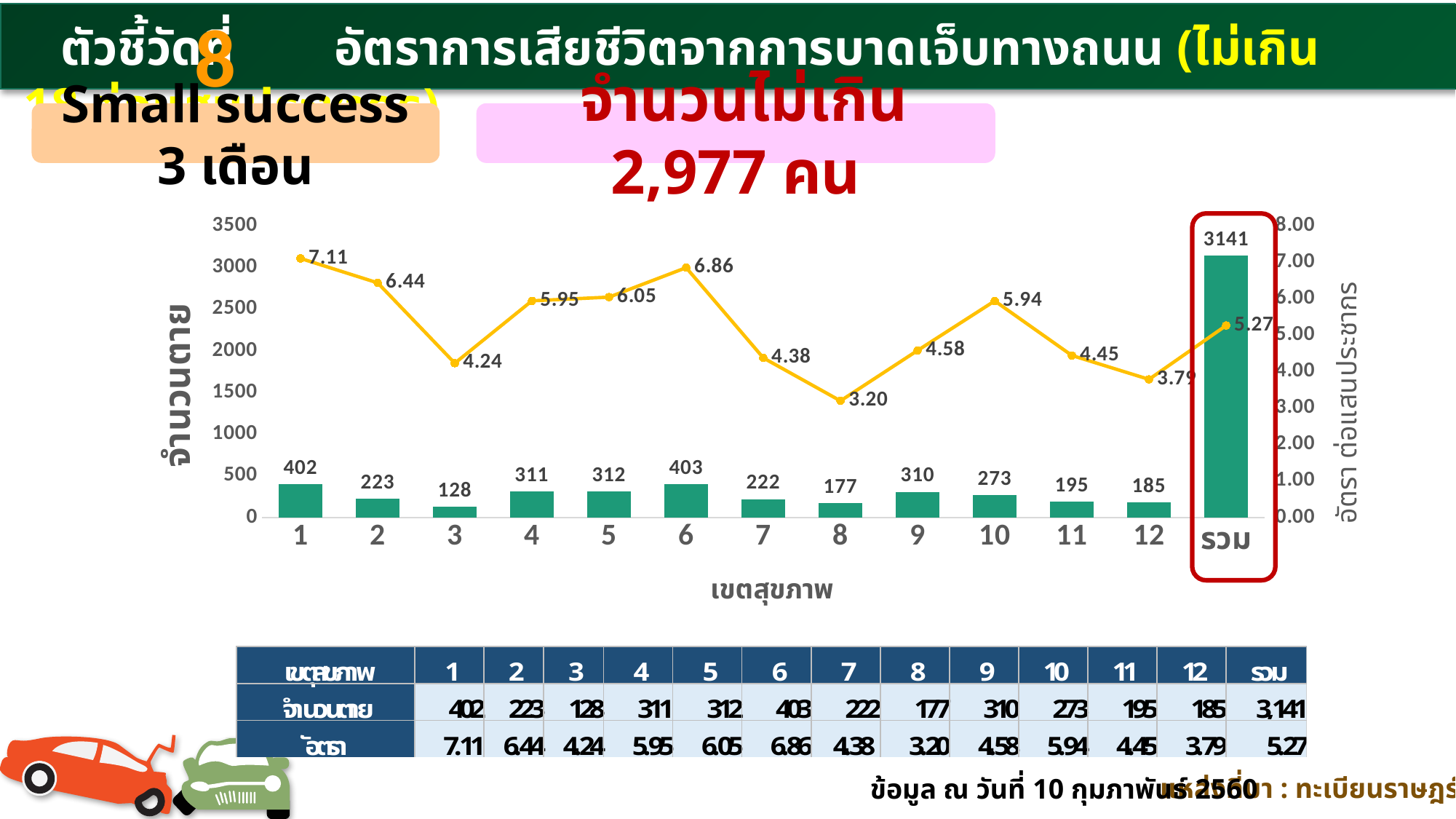
Does the rate line rise or fall from health region 1 to health region 3? Fall How many categories are shown on the x axis of the chart? 13 Which health region (1-12) has the lowest rate on the line? 8 What is the rate (line value) for health region 8? 3.20 What is the number of deaths (bar value) for health region 1? 402 What kind of chart is shown on the slide? Combination bar and line chart What is the value of the รวม (total) bar? 3141 What is the difference in deaths between health region 6 and health region 1? 1 Which health region (1-12) has the lowest number of deaths (bar)? 3 Which health region (1-12) has the highest rate on the line? 1 Which has more deaths, health region 4 or health region 5? 5 What is the x-axis title of the chart? เขตสุขภาพ